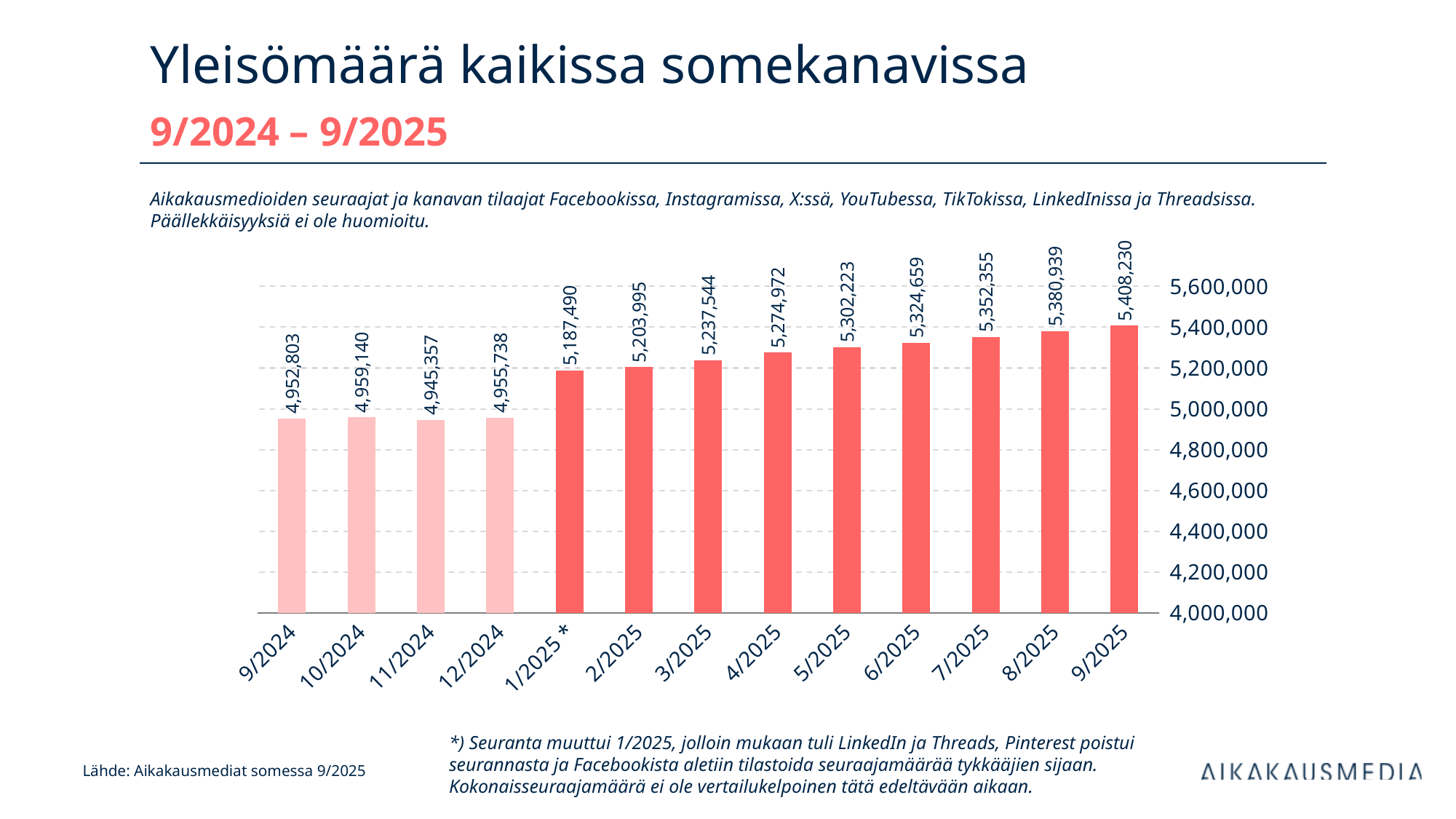
Which month has the highest value? 9/2025 What is the value for 9/2025? 5,408,230 What kind of chart is shown on the slide? bar chart What is the difference between the values for 9/2025 and 9/2024? 455,427 What is the value for 11/2024? 4,945,357 Do the values rise or fall from 1/2025 * to 9/2025? rise Is the value for 12/2024 greater or less than 5,000,000? less What is the difference between the values for 1/2025 * and 12/2024? 231,752 Which month has the lowest value? 11/2024 Which is larger, the value for 3/2025 or the value for 6/2025? 6/2025 What is the value for 1/2025 *? 5,187,490 How many months are shown on the x axis? 13